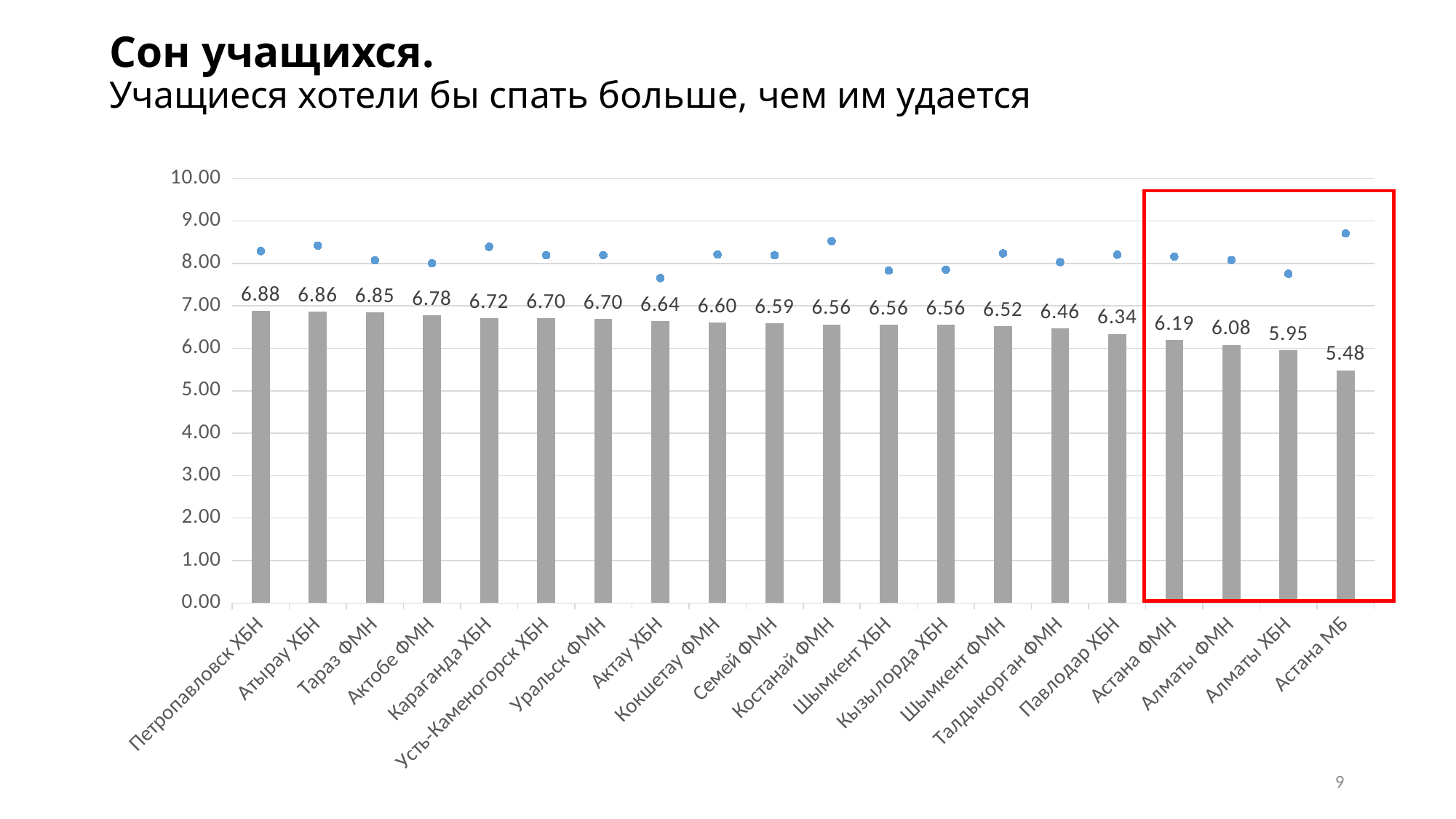
Which category has the highest bar value? Петропавловск ХБН What is the bar value for Астана МБ? 5.48 What is the difference between the bar values for Астана ФМН and Алматы ХБН? 0.24 What is the bar value for Караганда ХБН? 6.72 Is the value of the blue dot for Актау ХБН greater or less than 8.00? less Do the bar values rise or fall from left to right along the x axis? fall Which has a larger bar value, Актобе ФМН or Талдыкорган ФМН? Актобе ФМН Which category has the lowest bar value? Астана МБ Is the value of the blue dot for Астана МБ greater or less than 8.00? greater How many categories are shown on the x axis? 20 What is the difference between the bar values for Петропавловск ХБН and Астана МБ? 1.40 What is the bar value for Павлодар ХБН? 6.34